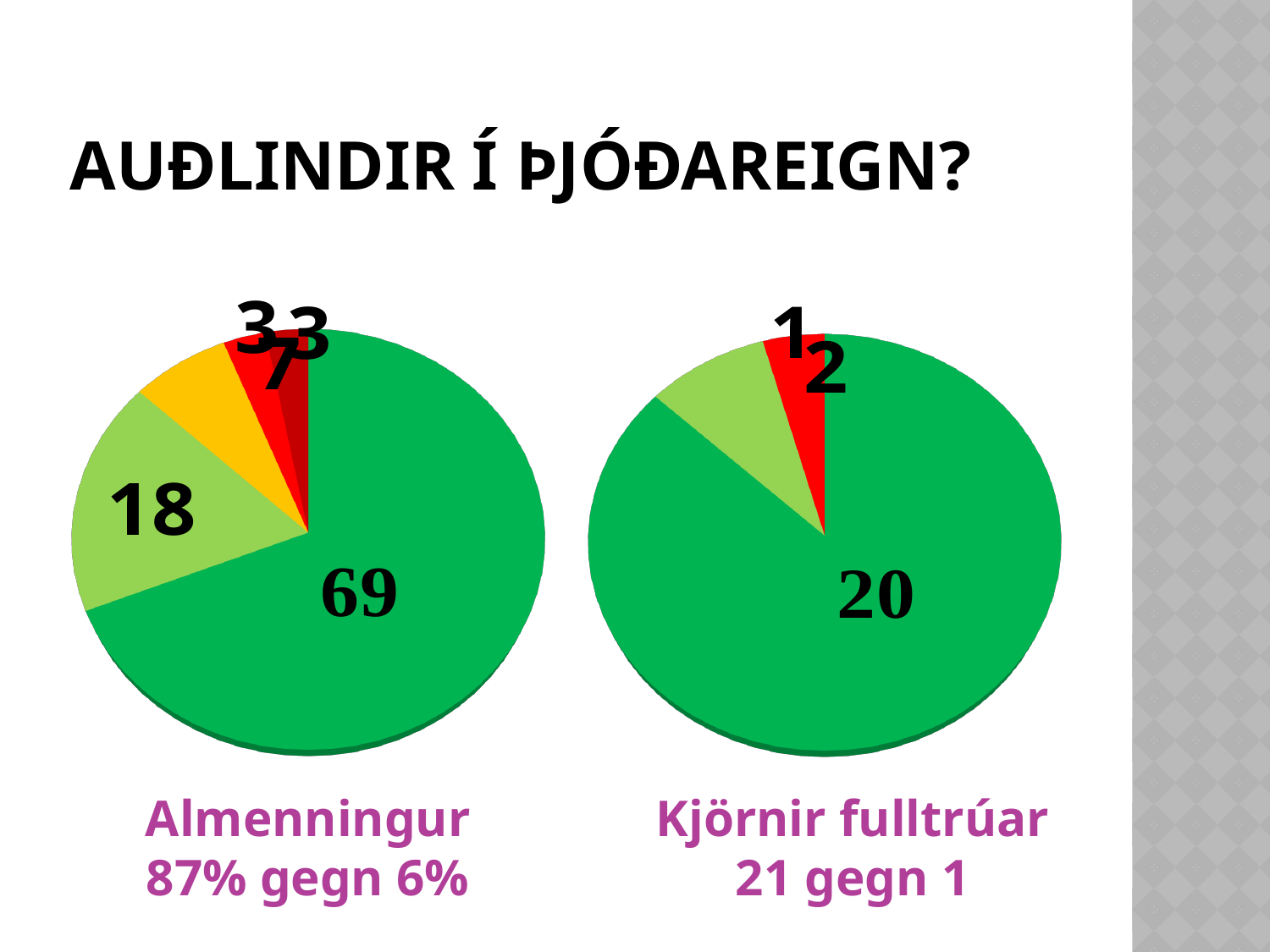
In the Kjörnir fulltrúar pie chart, which slice is the smallest? The red slice (1) What kind of chart is used on this slide for Almenningur and Kjörnir fulltrúar? Pie chart In the Kjörnir fulltrúar pie chart, what is the value of the largest (dark green) slice? 20 In the Almenningur pie chart, what is the difference between the dark green slice (69) and the light green slice (18)? 51 What result is written under the Kjörnir fulltrúar pie chart? 21 gegn 1 In the Almenningur pie chart, what is the value of the largest (dark green) slice? 69 How many slices does the Kjörnir fulltrúar pie chart have? 3 In the Almenningur pie chart, what is the value of the light green slice? 18 In the Almenningur pie chart, what is the value of the yellow slice? 7 In the Kjörnir fulltrúar pie chart, what is the difference between the dark green slice (20) and the light green slice (2)? 18 How many slices does the Almenningur pie chart have? 5 In the Kjörnir fulltrúar pie chart, what is the value of the red slice? 1